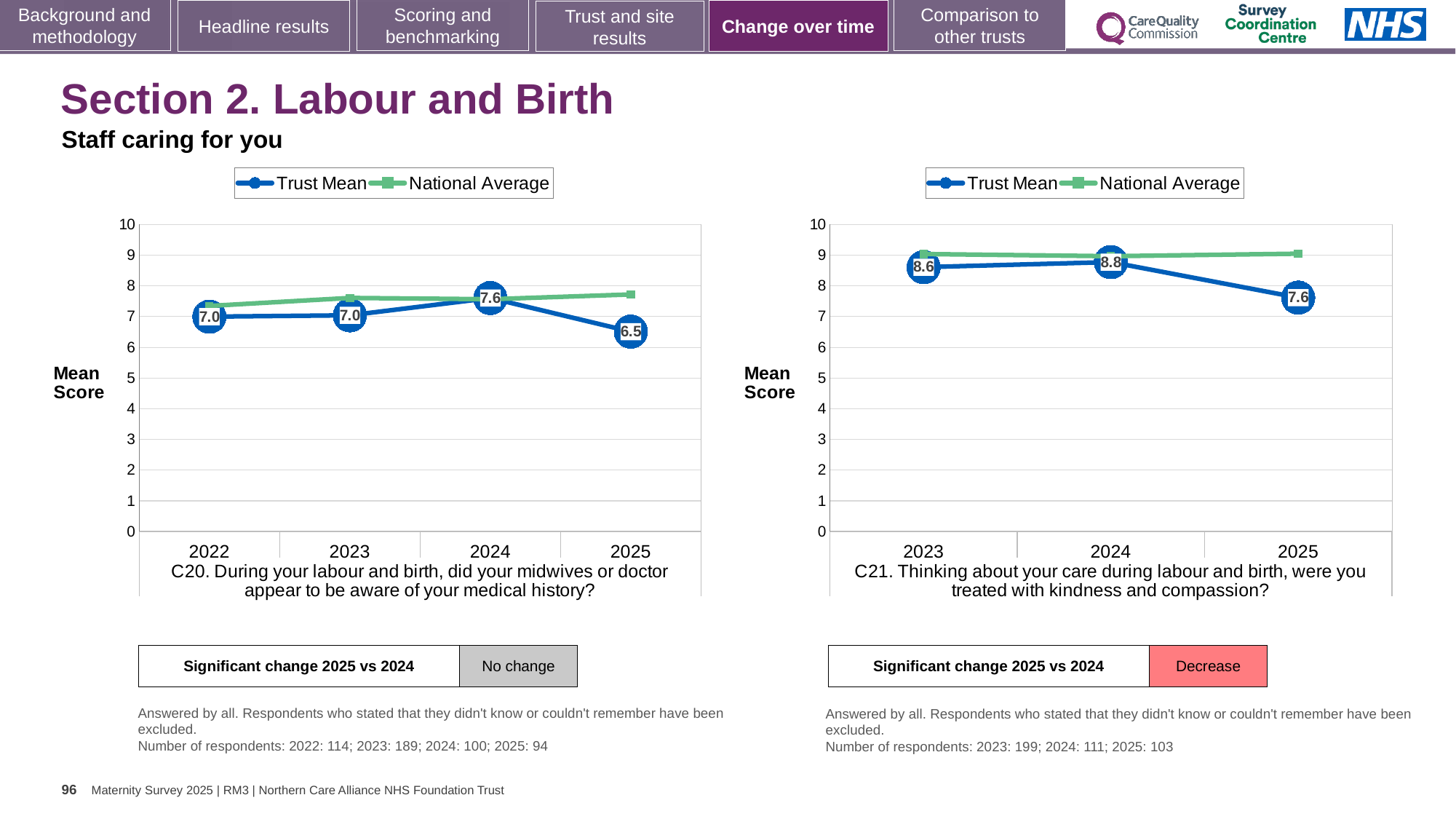
On the C20 chart (left), what is the Trust Mean for 2024? 7.6 On the C21 chart (right), what is the Trust Mean for 2023? 8.6 On the C20 chart (left), which year has the lowest Trust Mean? 2025 On the C21 chart (right), what is the difference between the Trust Mean for 2024 and 2025? 1.2 What type of chart is the C20 chart (left)? Line chart On the C20 chart (left), which year has the highest Trust Mean? 2024 On the C21 chart (right), which year has the lowest Trust Mean? 2025 On the C20 chart (left), what is the difference between the Trust Mean for 2024 and 2025? 1.1 On the C20 chart (left), is the National Average for 2025 greater or less than 7? greater On the C20 chart (left), what is the Trust Mean for 2025? 6.5 How many years are plotted on the C21 chart (right)? 3 On the C21 chart (right), what is the Trust Mean for 2024? 8.8